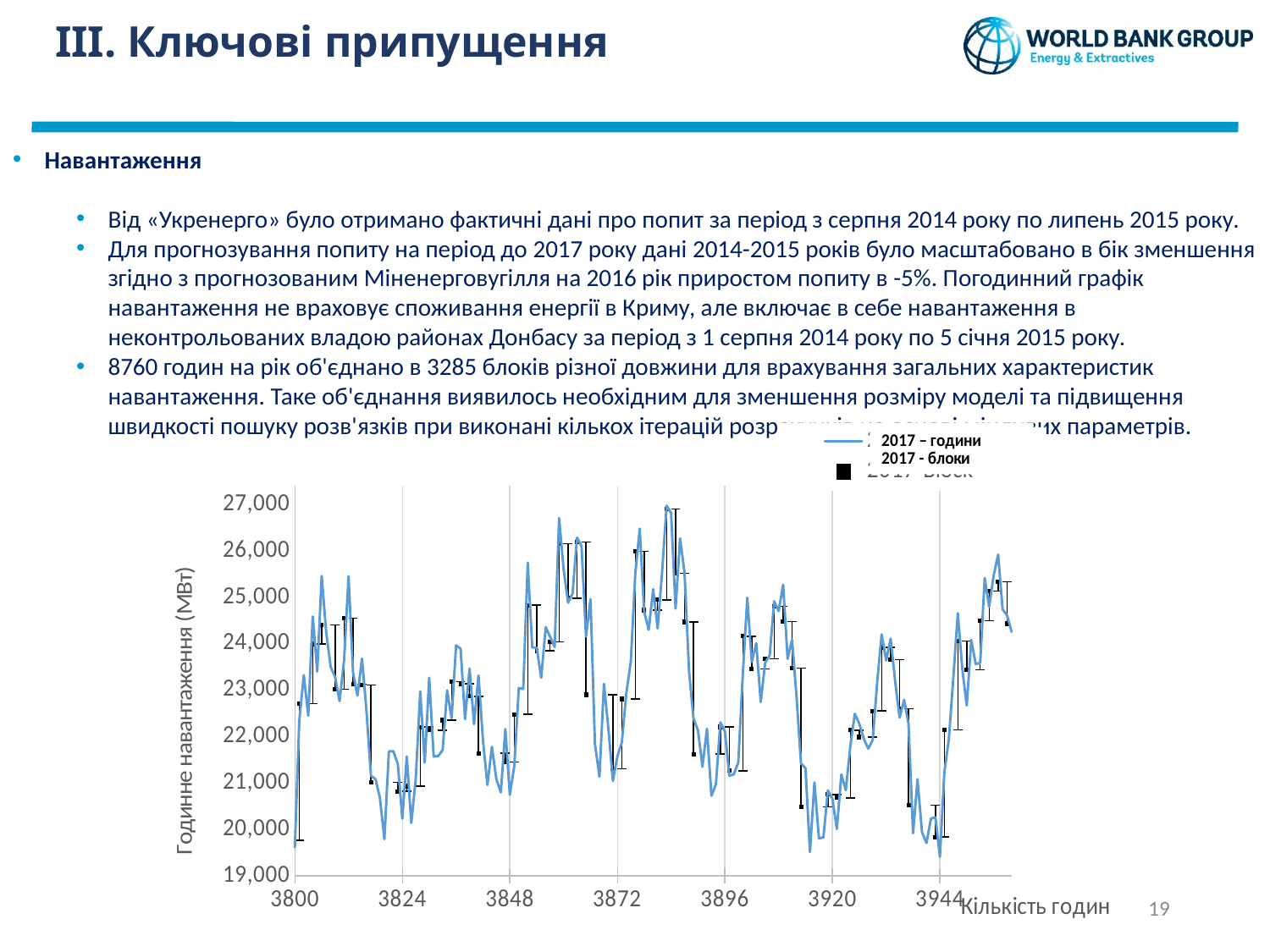
What are the two series named in the chart legend? 2017 – години and 2017 - блоки Is the lowest point of the '2017 – години' line near hour 3944 greater or less than 20,000? less Is the value of the '2017 – години' line at hour 3848 greater or less than 22,000? less What kind of chart is shown on the slide? line chart Is the value of the '2017 – години' line at hour 3800 greater or less than 20,000? less What is the highest value shown on the vertical axis of the chart? 27,000 What is the label of the vertical axis of the chart? Годинне навантаження (МВт) What is the lowest value shown on the vertical axis of the chart? 19,000 How many series does the chart legend list? 2 How many tick labels are shown on the horizontal axis of the chart? 7